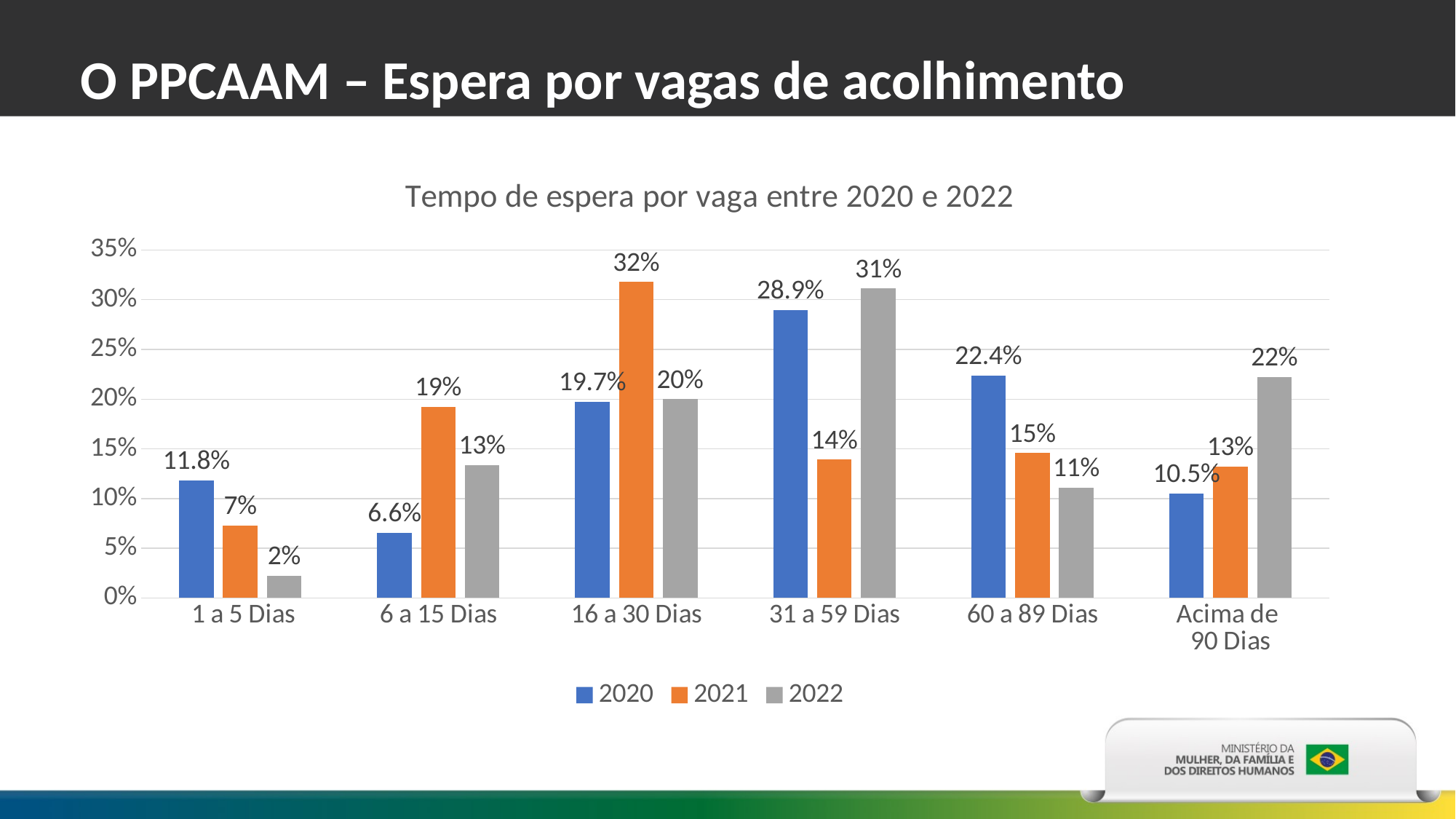
What is the value for 2020 in the '31 a 59 Dias' category? 28.9% Which colour represents the 2021 series in the legend? Orange What is the difference between the 2021 and 2022 values in the '6 a 15 Dias' category? 6% How many categories are shown on the x axis? 6 Which category has the highest value for the 2022 series? 31 a 59 Dias How many series does the legend list? 3 Which category has the lowest value for the 2020 series? 6 a 15 Dias What is the value for 2021 in the '16 a 30 Dias' category? 32% What is the title of the chart? Tempo de espera por vaga entre 2020 e 2022 What is the value for 2022 in the 'Acima de 90 Dias' category? 22% In the '60 a 89 Dias' category, which series has the larger value, 2020 or 2022? 2020 What kind of chart is shown on the slide? Bar chart